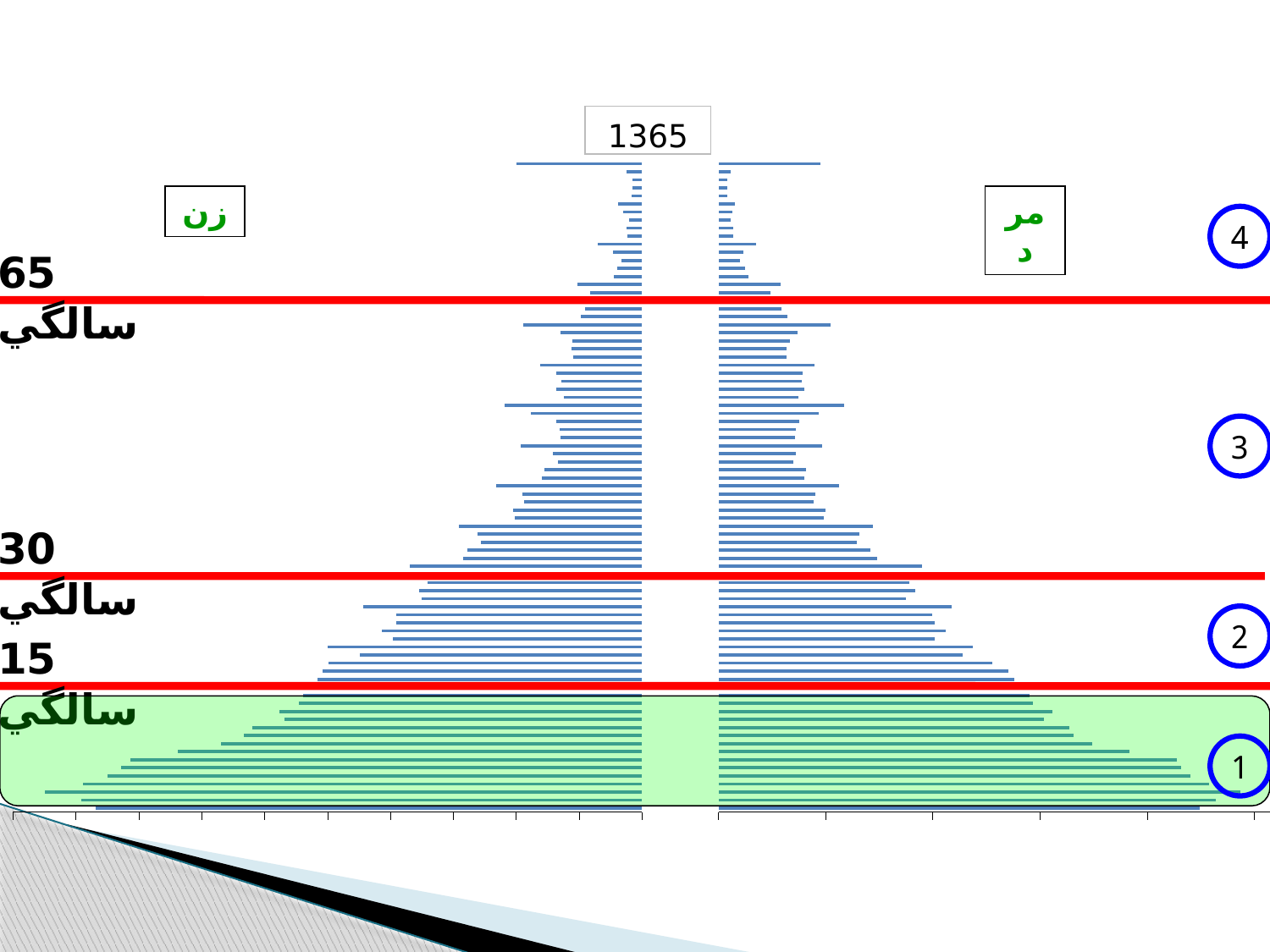
Which numbered zone contains the shortest bars? 4 What are the three age thresholds marked by the red lines? 15, 30, 65 Which side of the pyramid shows women (زن), left or right? left Are the bars in zone 1 (under 15) longer or shorter than the bars in zone 3 (30 to 65)? longer Which numbered zone contains the longest bars? 1 Do the bars get longer or shorter as age increases from the bottom to the top of the pyramid? shorter What year is shown in the title box above the chart? 1365 Which age threshold line is closest to the top of the pyramid: 15, 30 or 65? 65 What kind of chart is shown on the slide? bar chart How many numbered age zones are marked on the right side of the chart? 4